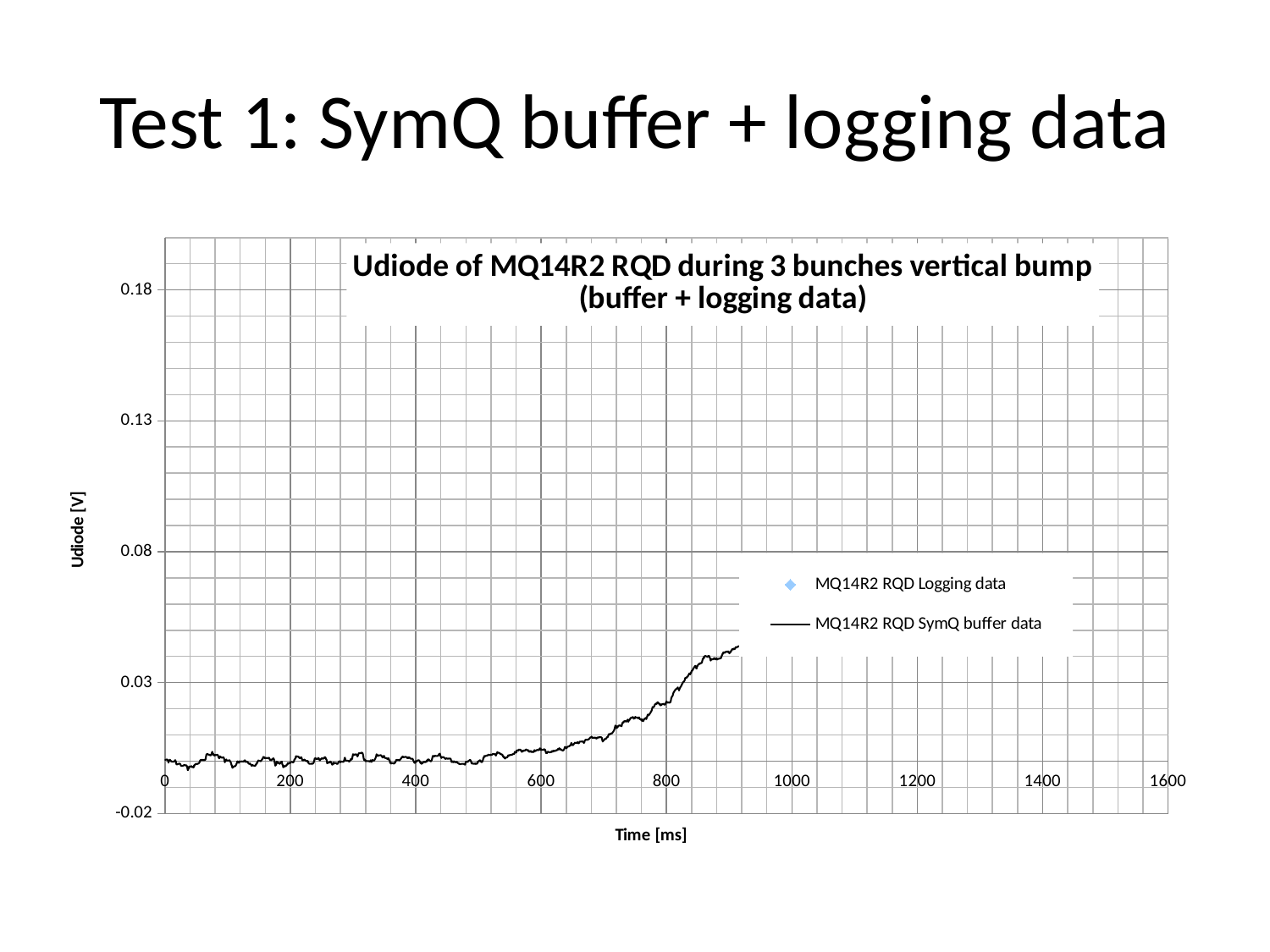
Does the SymQ buffer data rise or fall between 600 ms and 900 ms? rise Is the value of the SymQ buffer data at 900 ms greater or less than 0.03? greater Is the value of the SymQ buffer data at 900 ms greater or less than 0.08? less Is the value of the SymQ buffer data at 400 ms greater or less than 0.08? less What is the title of the chart? Udiode of MQ14R2 RQD during 3 bunches vertical bump (buffer + logging data) What kind of chart is shown on the slide? line chart Is the SymQ buffer data value higher at 900 ms or at 100 ms? 900 ms What is the label of the x axis? Time [ms] How many series does the legend list? 2